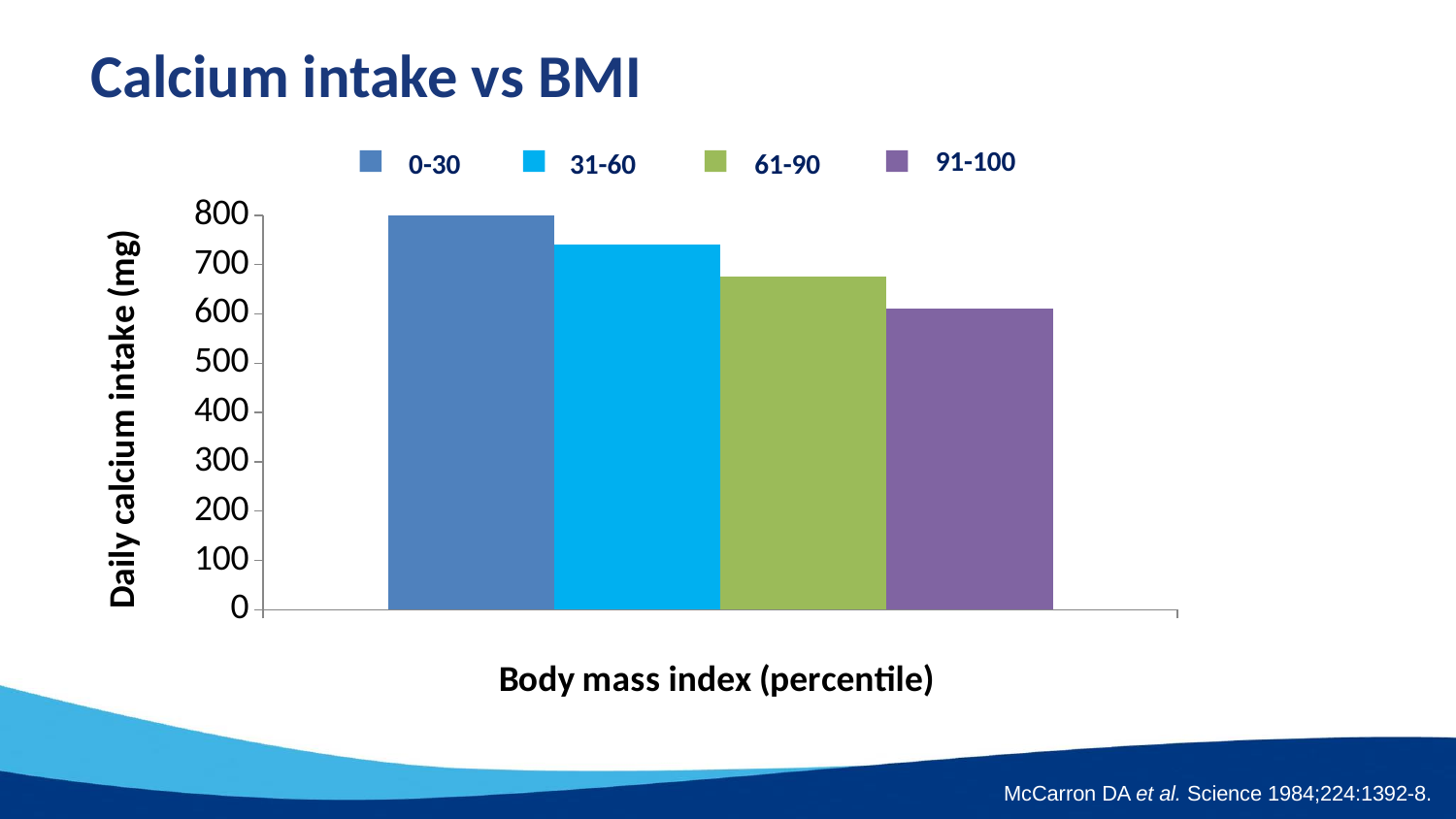
Is the daily calcium intake for the 61-90 group greater or less than 700 mg? less Which group has a higher daily calcium intake, 31-60 or 61-90? 31-60 What is the label of the vertical axis? Daily calcium intake (mg) Do the daily calcium intake values rise or fall as the BMI percentile increases? Fall What kind of chart is shown on the slide? Bar chart How many series does the legend list? 4 What is the daily calcium intake (mg) for the 0-30 BMI percentile group? 800 Is the daily calcium intake for the 31-60 group greater or less than 700 mg? greater Which BMI percentile group has the lowest daily calcium intake? 91-100 Which BMI percentile group has the highest daily calcium intake? 0-30 How many bars are plotted in the chart? 4